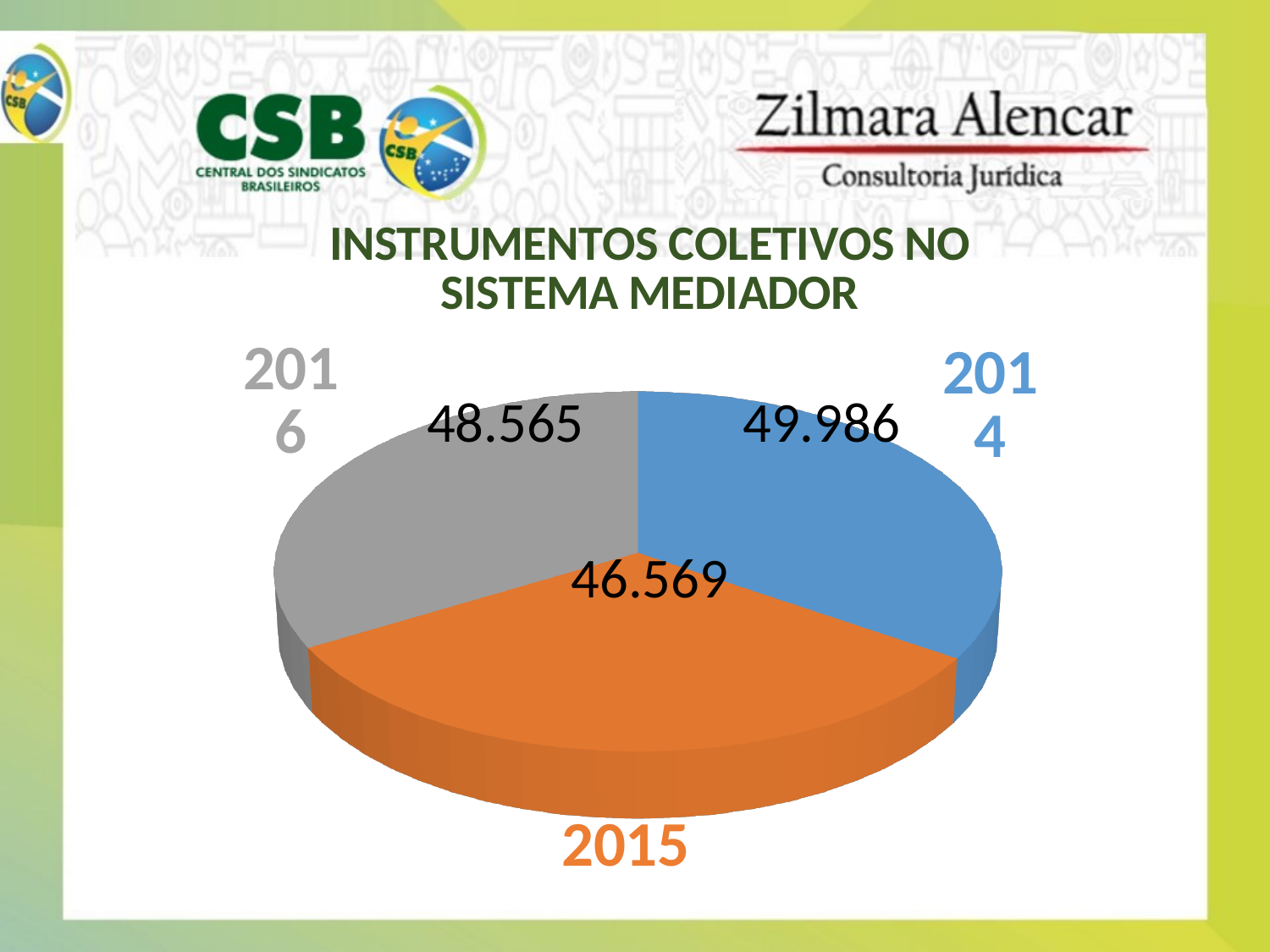
What is the value shown for 2014? 49.986 What is the title of the chart? INSTRUMENTOS COLETIVOS NO SISTEMA MEDIADOR What colour is the slice for 2015? orange What is the value shown for 2015? 46.569 What is the difference between the values for 2014 and 2015? 3.417 What is the difference between the values for 2016 and 2015? 1.996 What is the value shown for 2016? 48.565 Which year has the largest slice of the pie? 2014 How many slices does the pie chart have? 3 What kind of chart is shown on the slide? pie chart Which is larger, the value for 2014 or the value for 2016? 2014 Which year has the smallest slice of the pie? 2015